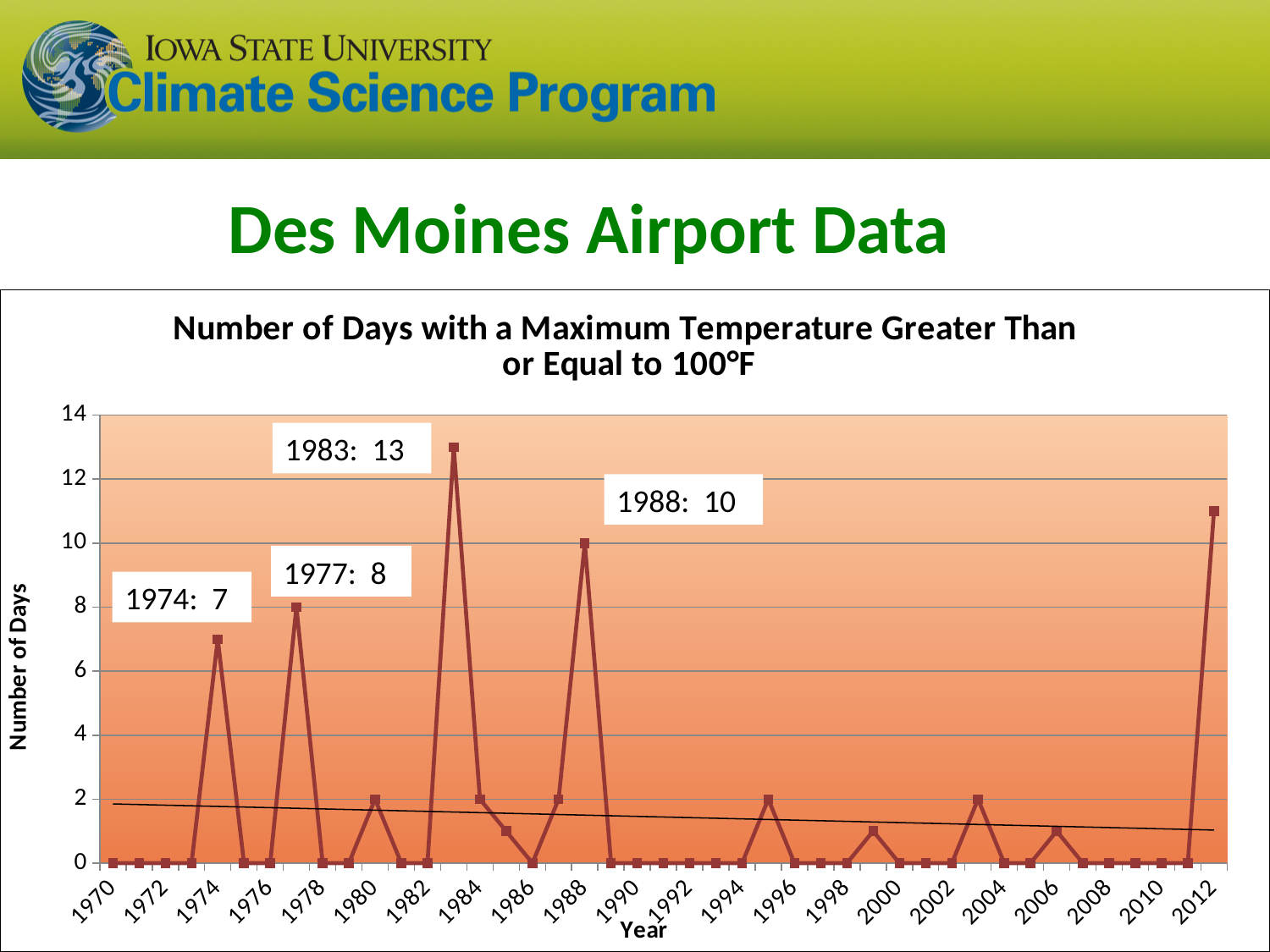
What is the difference between the values for 1983 and 1988? 3 Does the straight trend line drawn across the chart rise or fall from 1970 to 2012? fall How many days with a maximum temperature of at least 100°F were recorded in 1983? 13 What is the value labelled for 1977? 8 What is the title of the vertical axis? Number of Days What kind of chart is shown on the slide? line chart What is the value for 1980? 2 Is the value for 2012 greater or less than 10? greater Which year has the highest number of days with a maximum temperature greater than or equal to 100°F? 1983 What is the value labelled for 1988? 10 What is the value labelled for 1974? 7 Which year has the larger value, 1974 or 1977? 1977